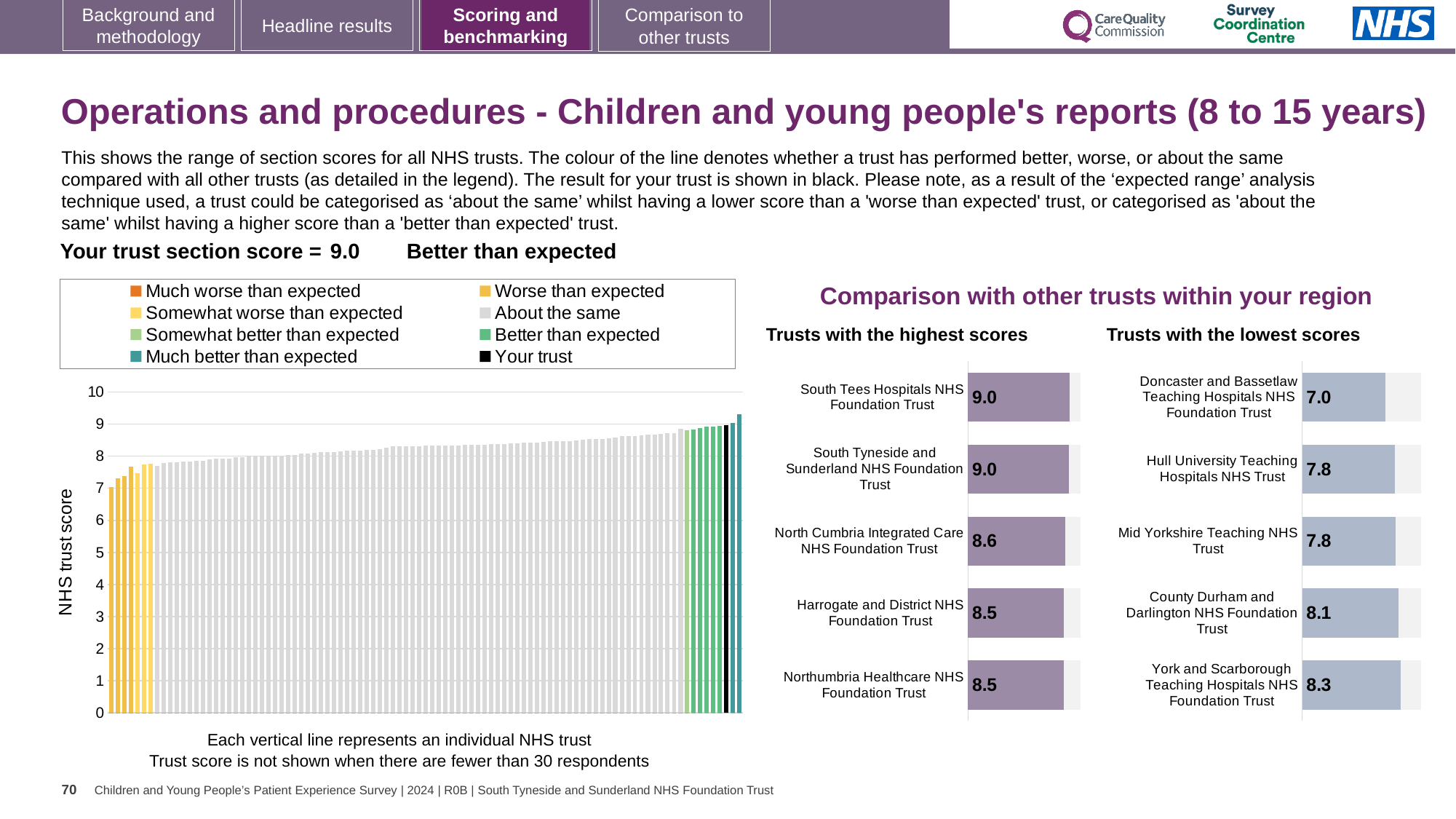
In the main NHS trust score chart, is the value of the leftmost bar greater or less than 8? less In the 'Trusts with the highest scores' chart, what is the score for North Cumbria Integrated Care NHS Foundation Trust? 8.6 In the 'Trusts with the lowest scores' chart, what is the difference between the scores of York and Scarborough Teaching Hospitals NHS Foundation Trust and Doncaster and Bassetlaw Teaching Hospitals NHS Foundation Trust? 1.3 What kind of chart is the main chart showing the range of NHS trust scores? Bar chart In the main NHS trust score chart, do the bars rise or fall from left to right? Rise In the 'Trusts with the lowest scores' chart, what is the score for Hull University Teaching Hospitals NHS Trust? 7.8 How many trusts are listed in the 'Trusts with the highest scores' chart? 5 In the 'Trusts with the lowest scores' chart, which trust has the lowest score? Doncaster and Bassetlaw Teaching Hospitals NHS Foundation Trust In the 'Trusts with the lowest scores' chart, which trust has the highest score? York and Scarborough Teaching Hospitals NHS Foundation Trust How many entries does the legend of the main NHS trust score chart list? 8 In the 'Trusts with the highest scores' chart, what is the difference between the scores of North Cumbria Integrated Care NHS Foundation Trust and Harrogate and District NHS Foundation Trust? 0.1 In the 'Trusts with the lowest scores' chart, which has the larger score: Hull University Teaching Hospitals NHS Trust or County Durham and Darlington NHS Foundation Trust? County Durham and Darlington NHS Foundation Trust